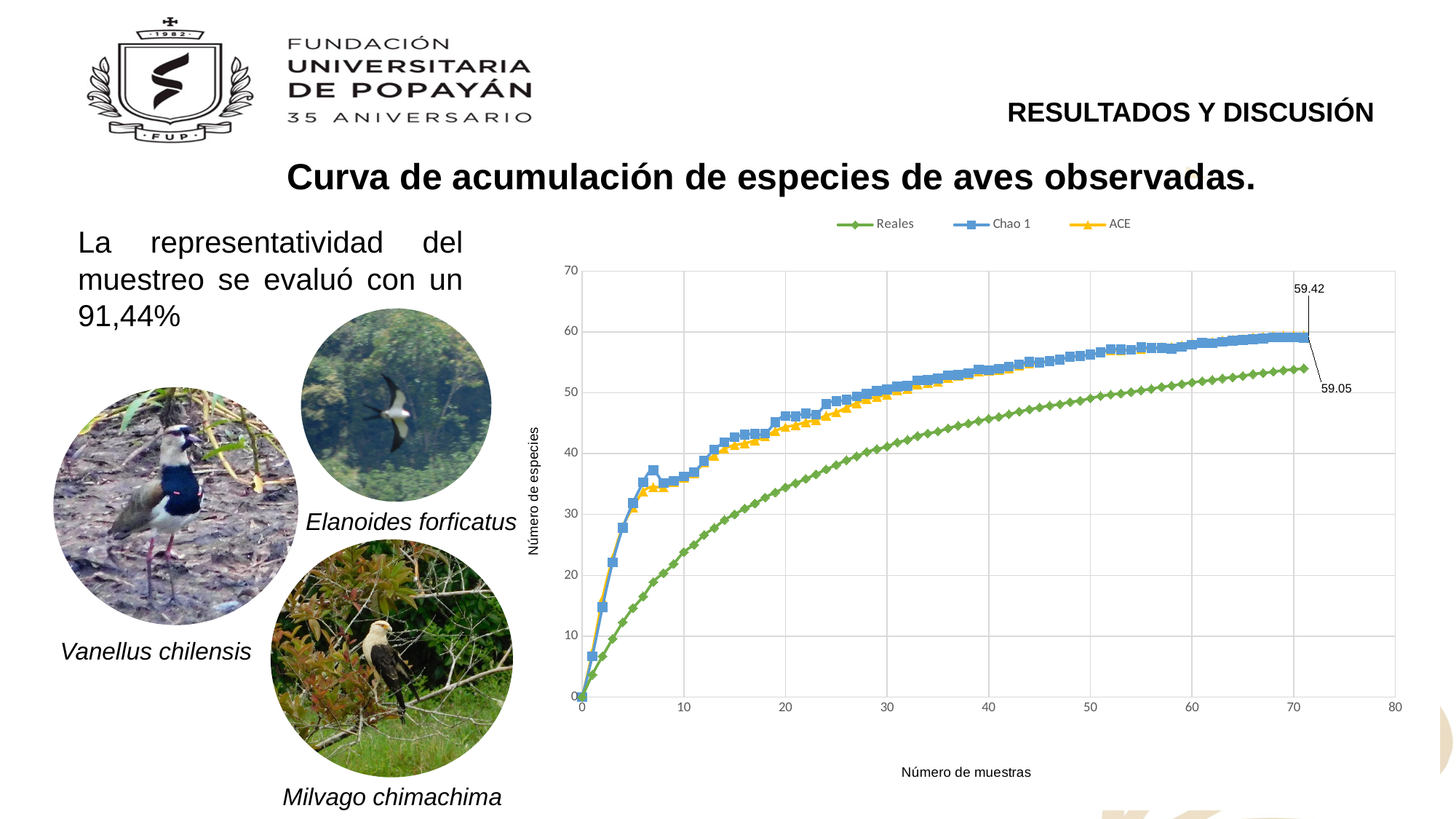
Is the value of the Chao 1 series at 10 samples greater or less than 30? greater At 40 samples, which series has the larger value, Chao 1 or Reales? Chao 1 What kind of chart is shown on the slide? line chart What is the label of the chart's vertical axis? Número de especies What are the three series named in the chart legend? Reales, Chao 1, ACE What is the lower of the two data label values printed at the right end of the curves? 59.05 Which series has the lowest value at the right end of the chart (around 70 samples)? Reales What is the highest data label value printed on the chart? 59.42 How many series does the chart legend list? 3 Is the value of the Reales series at 10 samples greater or less than 30? less Is the value of the Reales series at 70 samples greater or less than 50? greater Do the values of the Reales series rise or fall as the number of samples increases? rise